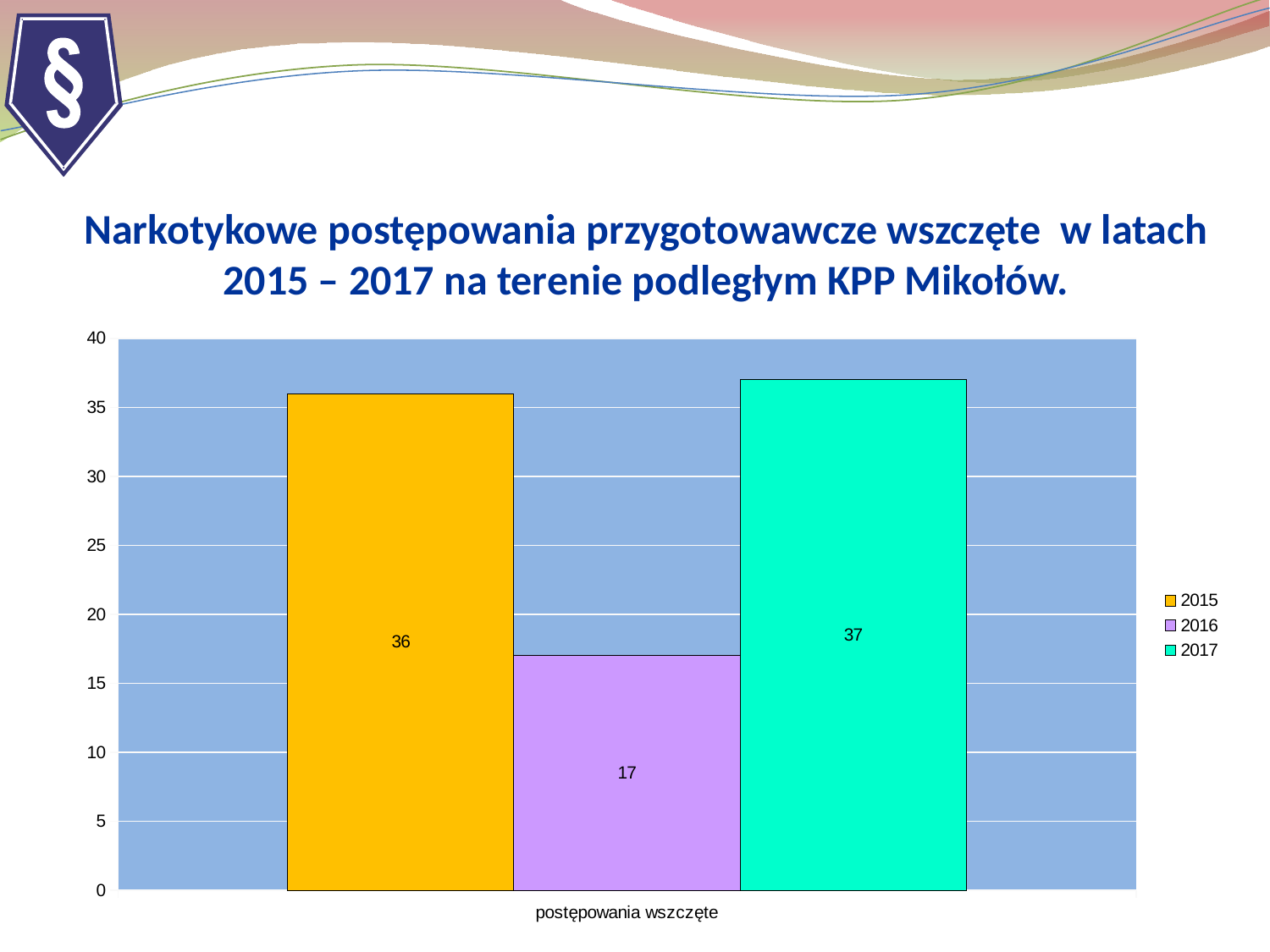
What colour is the bar for 2017? turquoise Which is larger, the value for 2015 or the value for 2016? 2015 Is the value for 2016 greater or less than 20? less What kind of chart is shown on the slide? bar chart What is the difference between the values for 2015 and 2016? 19 What is the value for 2015? 36 What is the value for 2016? 17 What is the category label shown below the bars? postępowania wszczęte Which year has the lowest value? 2016 What is the value for 2017? 37 What is the difference between the values for 2017 and 2016? 20 How many series does the legend list? 3